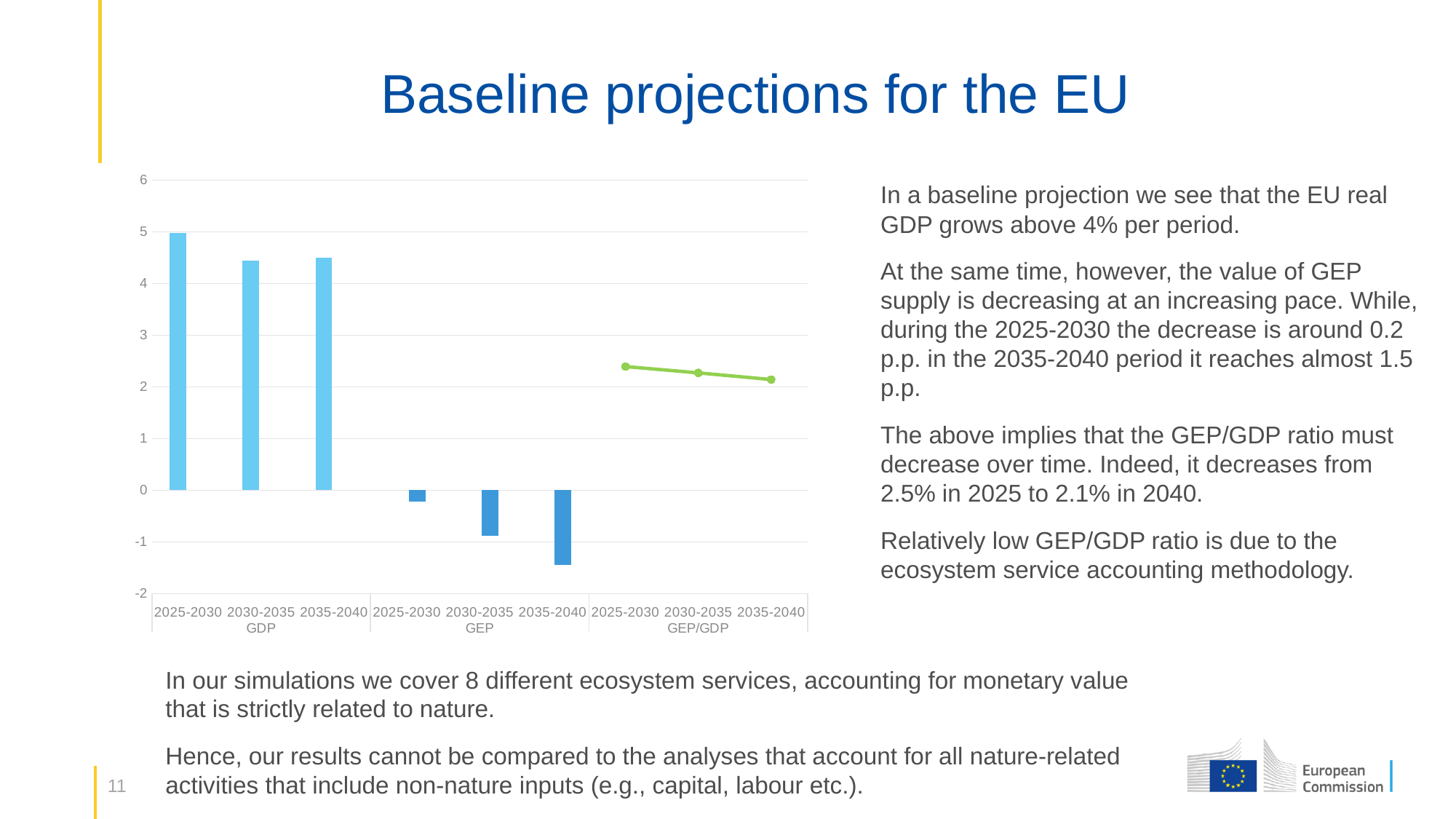
How many groups of categories are shown along the x axis of the chart? 3 What kind of chart is shown on the slide? A combined bar and line chart Which is larger, the GDP value for 2025-2030 or the GDP value for 2030-2035? 2025-2030 Is the GEP value for 2025-2030 greater or less than -1? greater Is the GEP/GDP value for 2025-2030 greater or less than 2? greater Which period has the highest GDP bar in the chart? 2025-2030 Which period has the lowest GEP bar in the chart? 2035-2040 Is the GEP value for 2035-2040 greater or less than -1? less How many bars or points are plotted in total across the chart? 9 Which series in the chart is drawn as a green line rather than bars? GEP/GDP Do the GEP/GDP values rise or fall from 2025-2030 to 2035-2040? fall